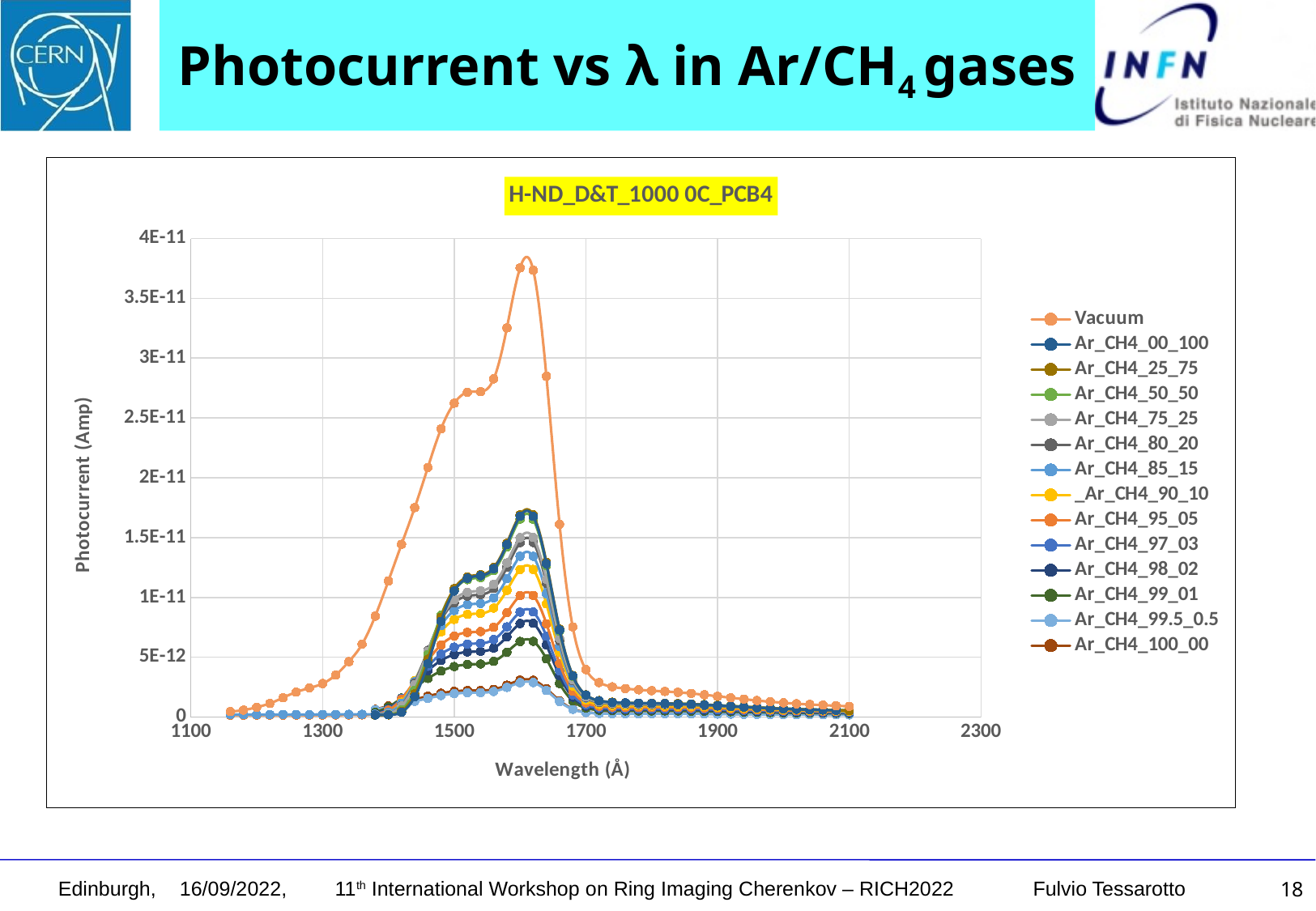
Is the peak value of the Ar_CH4_99_01 series greater or less than 5E-12? greater What kind of chart is shown on the slide? line chart Does the Vacuum series rise or fall as the wavelength increases from 1300 to 1600? rise Which series has the larger peak photocurrent, Vacuum or Ar_CH4_00_100? Vacuum How many series does the legend list? 14 Is the peak value of the Ar_CH4_100_00 series greater or less than 5E-12? less Which series reaches the highest photocurrent? Vacuum Is the peak value of the Vacuum series greater or less than 3.5E-11? greater What is the label of the x axis? Wavelength (Å) Which series has the larger peak photocurrent, Ar_CH4_00_100 or Ar_CH4_99_01? Ar_CH4_00_100 What is the title of the chart? H-ND_D&T_1000 0C_PCB4